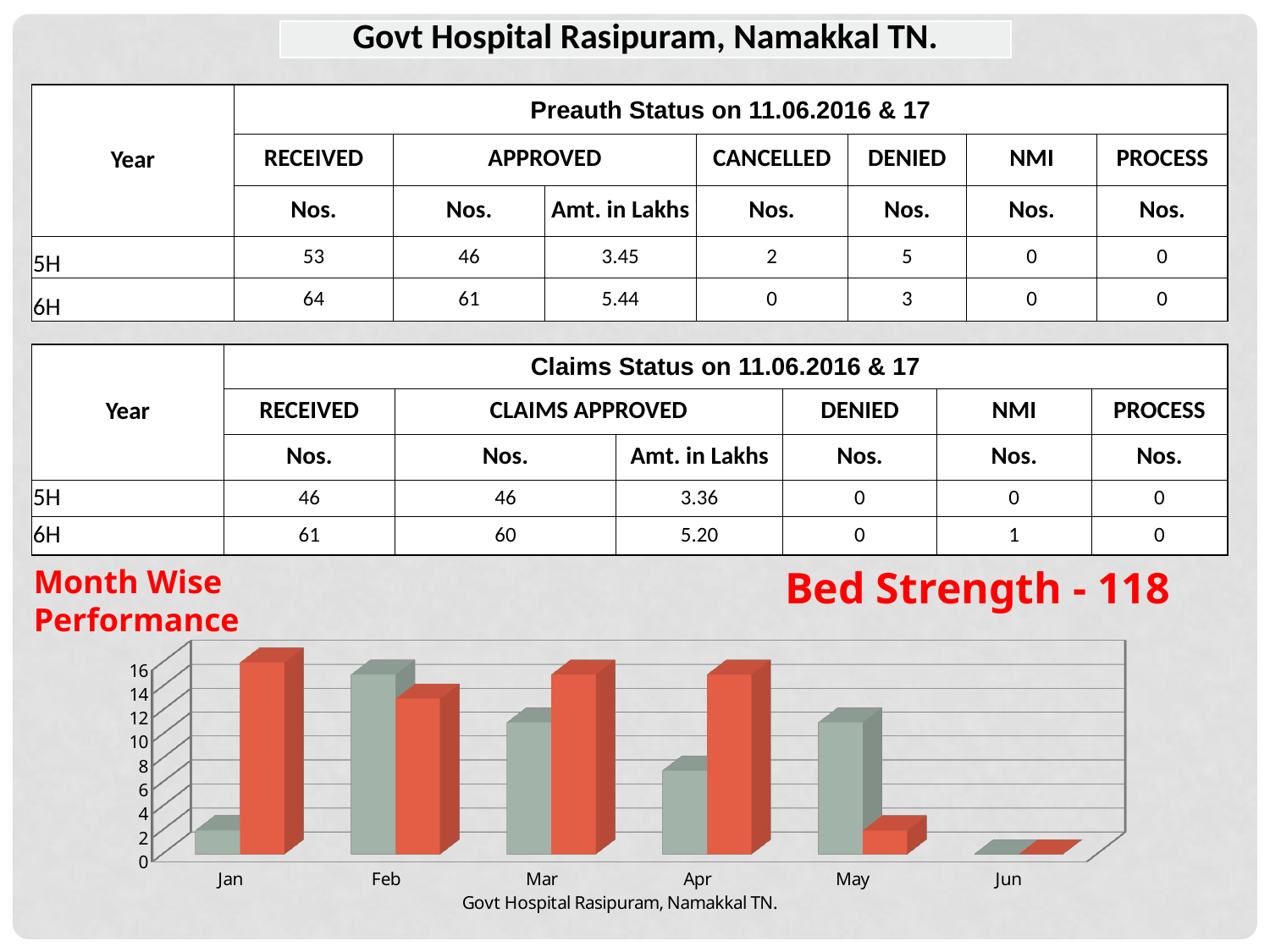
What text appears below the x axis of the chart? Govt Hospital Rasipuram, Namakkal TN. Is the orange bar for May greater or less than 6? less Is the grey bar for Apr greater or less than 10? less Which month has the tallest grey bar in the chart? Feb In Feb, which bar is taller, the grey bar or the orange bar? grey bar Is the grey bar for Jan greater or less than 4? less In Mar, which bar is taller, the grey bar or the orange bar? orange bar How many months are shown on the x axis of the chart? 6 Which month has the tallest orange bar in the chart? Jan What kind of chart is shown at the bottom of the slide? bar chart Which month has the shortest grey bar in the chart? Jun